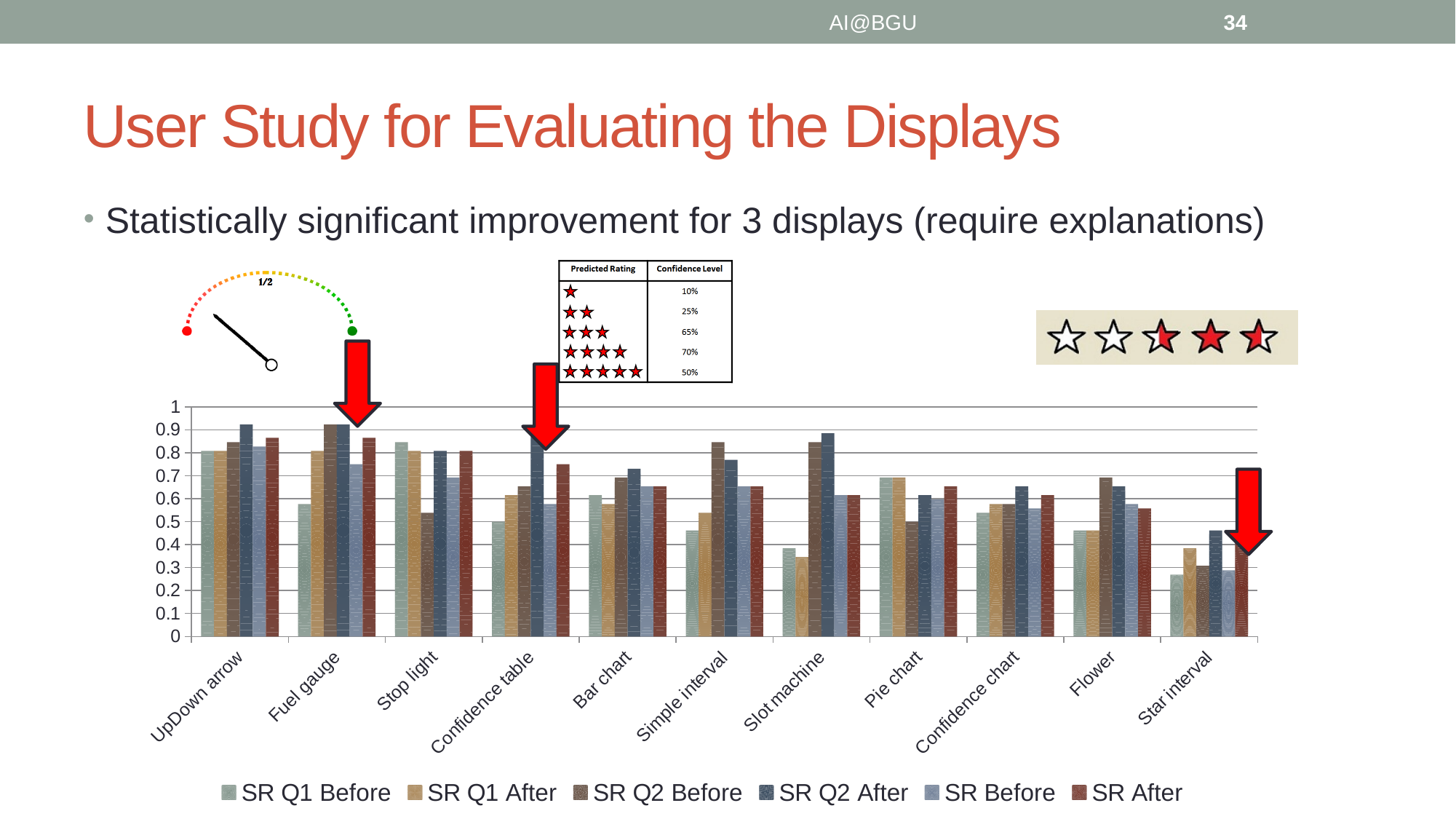
Is the SR Q1 Before value for Slot machine greater or less than 0.5? less Which category has the lowest SR Q1 Before value? Star interval What kind of chart is shown on the slide? bar chart How many series does the chart's legend list? 6 For Slot machine, which is larger: SR Q1 Before or SR Q2 Before? SR Q2 Before Is the SR Q2 After value for Slot machine greater or less than 0.8? greater What is the first series listed in the chart's legend? SR Q1 Before Is the SR Q2 Before value for Fuel gauge greater or less than 0.8? greater For Star interval, which is larger: SR Q2 Before or SR Q2 After? SR Q2 After How many display categories are shown along the x axis of the chart? 11 Which category has the lowest SR After value? Star interval